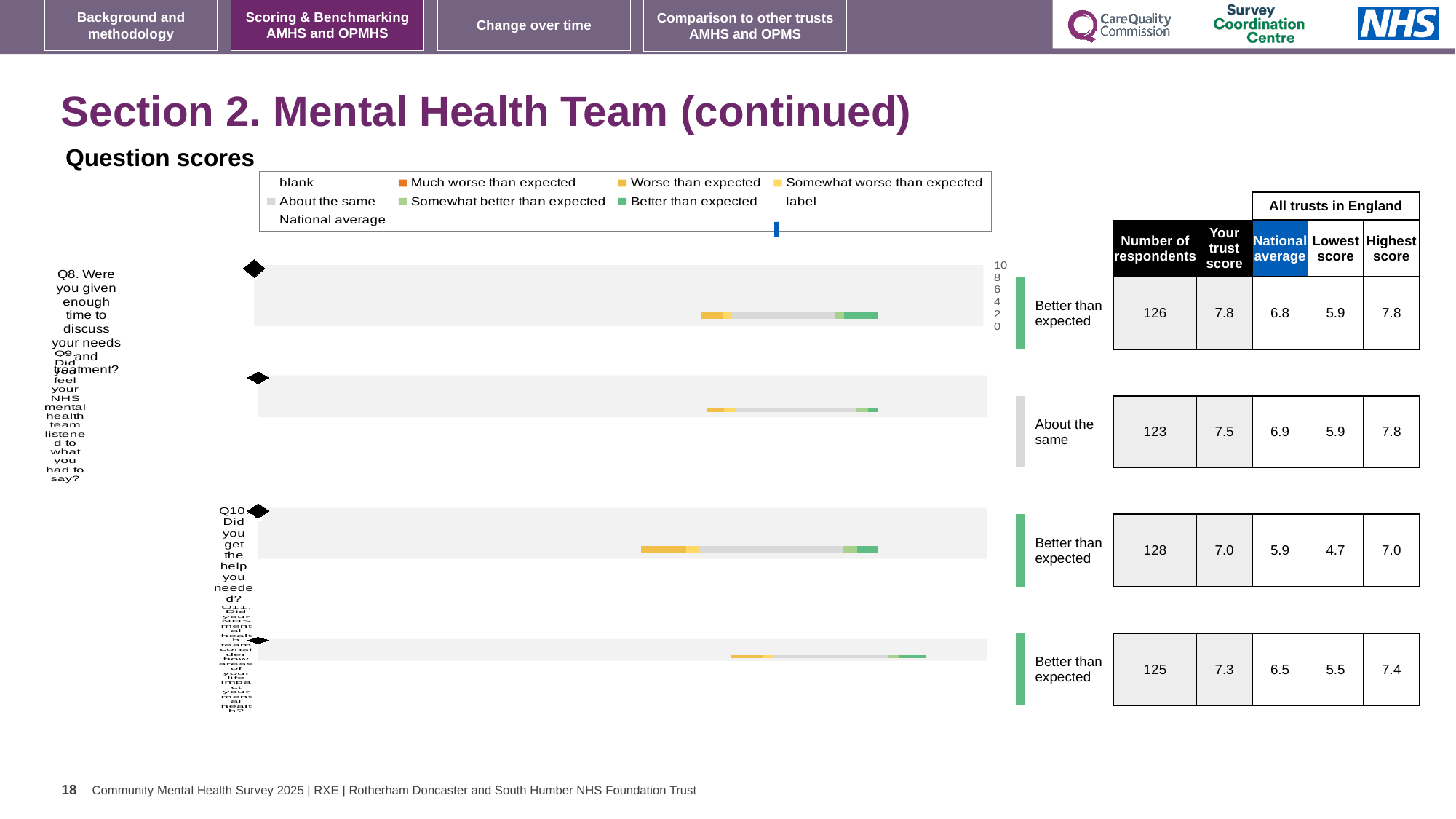
For the Q10 chart, what is the difference between the trust score and the national average? 1.1 For the Q10 chart (Did you get the help you needed?), what is the lowest score among all trusts in England? 4.7 For the Q8 chart, what is the number of respondents? 126 What rating label is shown next to the Q9 chart? About the same For the Q9 chart (Did you feel your NHS mental health team listened to what you had to say?), what is the national average? 6.9 For the Q11 chart, what is the highest score among all trusts in England? 7.4 Which question chart (Q8 to Q11) has the lowest number of respondents? Q9 Which question chart (Q8 to Q11) has the highest 'Your trust score'? Q8 What kind of chart is used for the question scores on this slide? bar chart How many question charts (Q8 to Q11) are shown on the slide? 4 For the Q8 chart (Were you given enough time to discuss your needs and treatment?), what is the 'Your trust score' shown in the table? 7.8 For the Q8 chart, which is larger: the trust score or the national average? the trust score